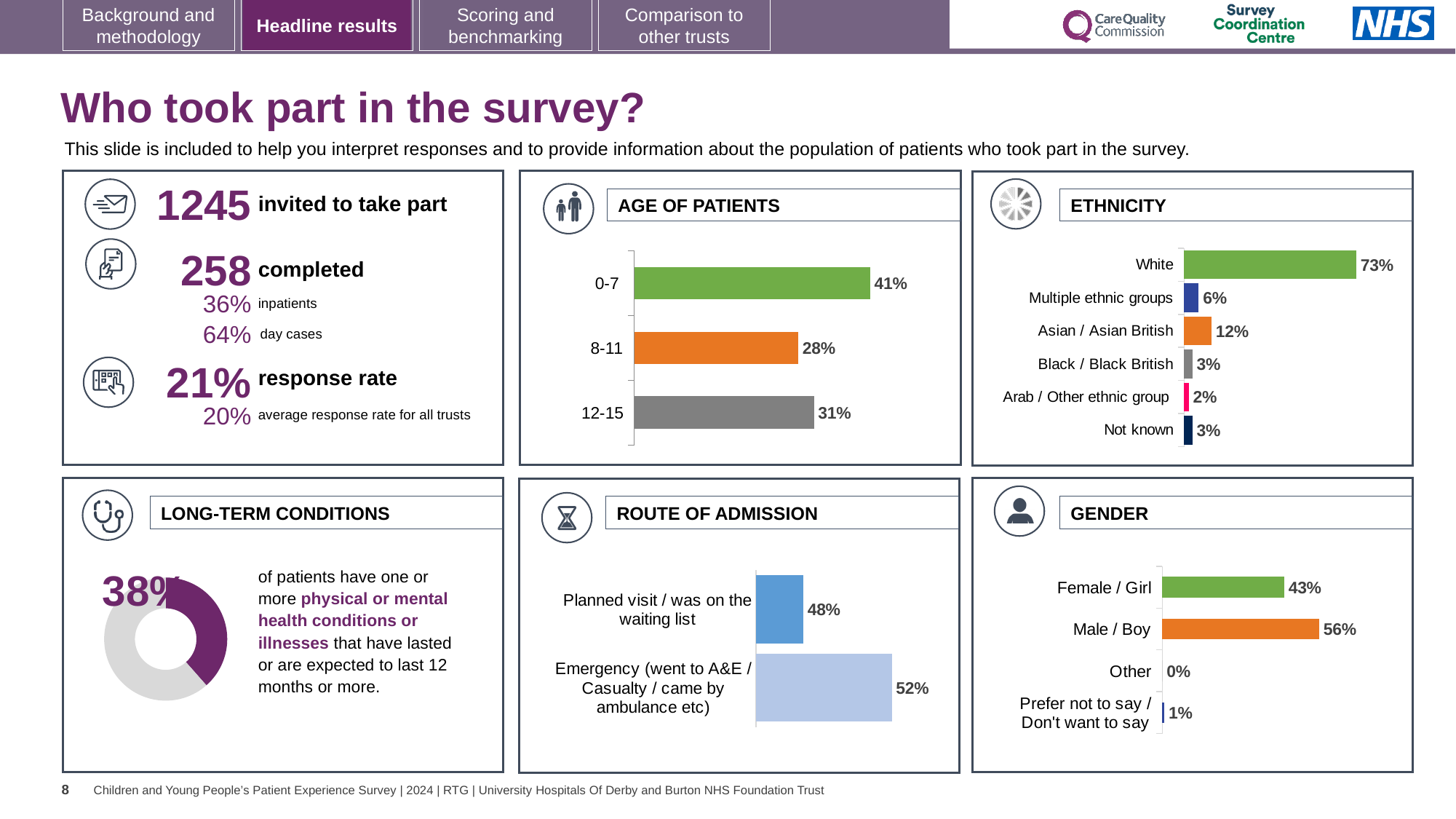
In the ROUTE OF ADMISSION chart, what is the value for Emergency (went to A&E / Casualty / came by ambulance etc)? 52% In the ROUTE OF ADMISSION chart, which is larger: Planned visit / was on the waiting list or Emergency? Emergency In the ETHNICITY chart, which category has the highest value? White In the GENDER chart, what is the difference between Male / Boy and Female / Girl? 13% How many categories are shown in the ETHNICITY chart? 6 In the GENDER chart, what is the value for Male / Boy? 56% In the ETHNICITY chart, what is the difference between White and Multiple ethnic groups? 67% In the AGE OF PATIENTS chart, which age group has the lowest percentage? 8-11 In the ETHNICITY chart, what is the value for Asian / Asian British? 12% In the LONG-TERM CONDITIONS chart, what percentage of patients have one or more long-term conditions? 38% What type of chart is used in the LONG-TERM CONDITIONS panel? Doughnut chart In the AGE OF PATIENTS chart, what percentage of patients were aged 0-7? 41%